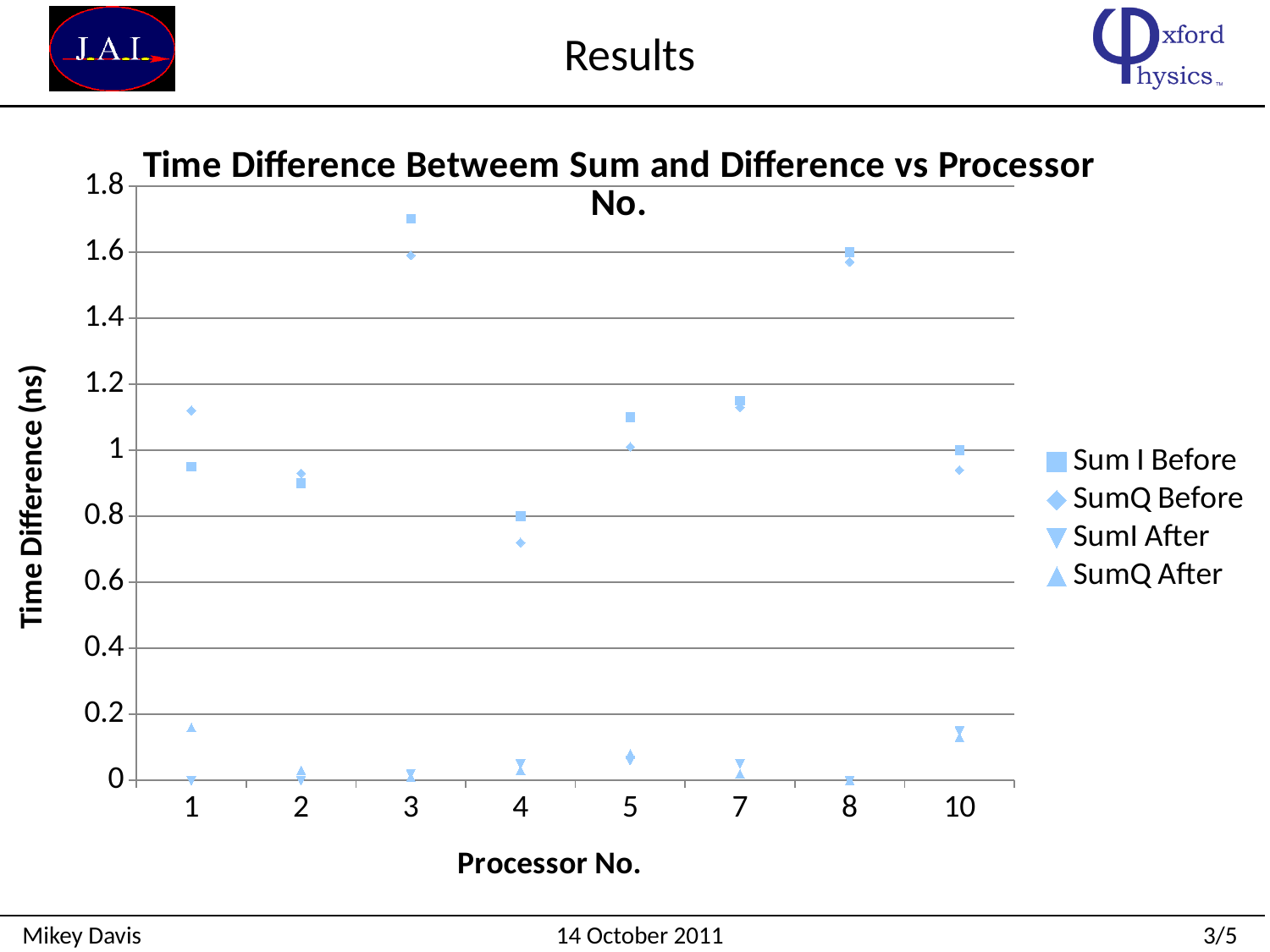
Is the SumQ After value for processor 1 greater or less than 0.2? less How many processor numbers are plotted along the x axis? 8 How many series does the legend list? 4 For which processor number is the Sum I Before value lowest? 4 Which is larger: the Sum I Before value for processor 3 or for processor 8? processor 3 For which processor number is the Sum I Before value highest? 3 What is the title of the y axis? Time Difference (ns) For processor 1, which is larger: the SumQ Before value or the Sum I Before value? SumQ Before Is the SumQ Before value for processor 4 greater or less than 0.8? less Is the Sum I Before value for processor 3 greater or less than 1.6? greater What kind of chart is shown on the slide? scatter chart